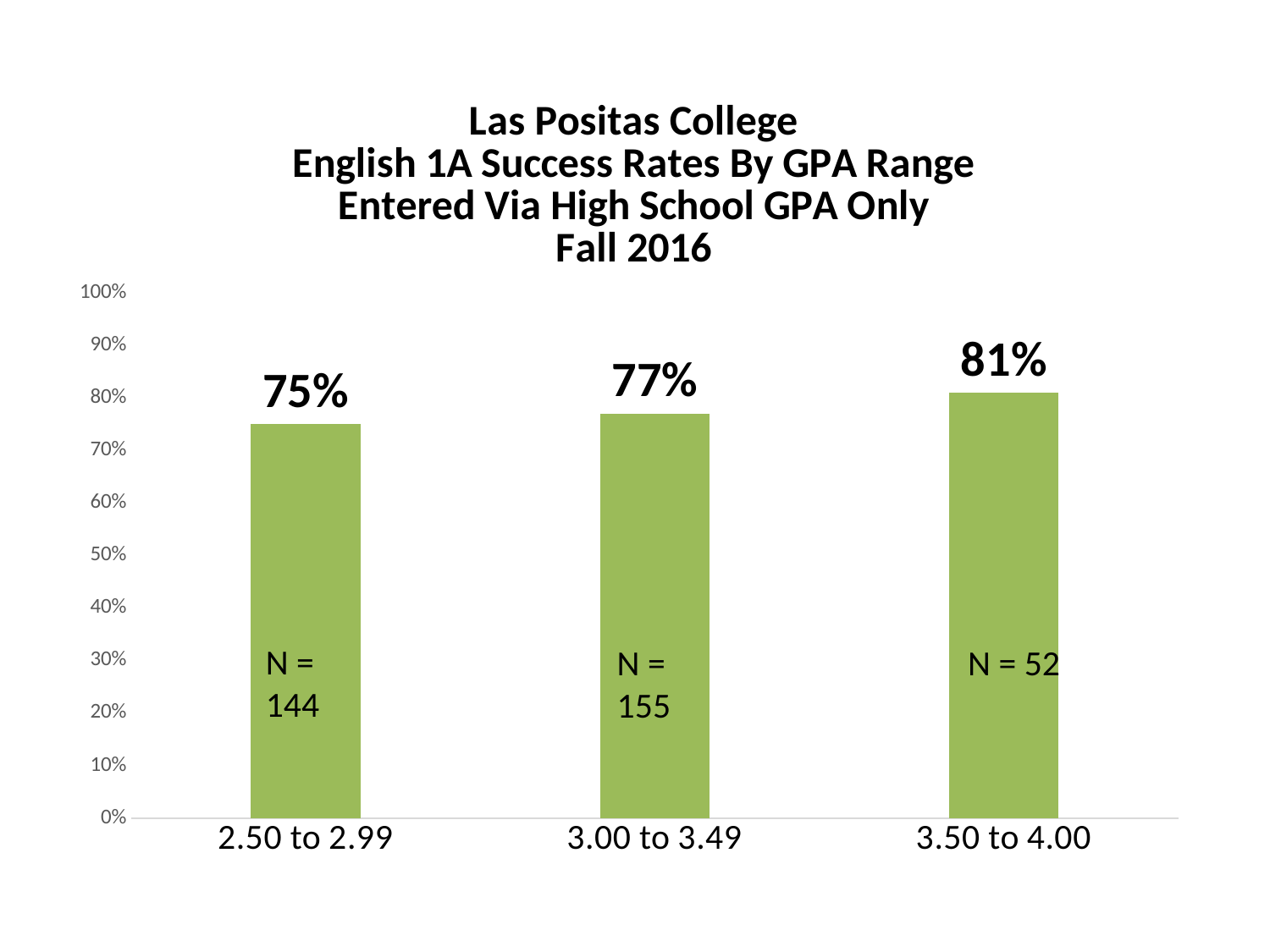
What is the difference in success rate between the 3.50 to 4.00 and 2.50 to 2.99 GPA ranges? 6% Which GPA range has the lowest success rate? 2.50 to 2.99 What is the N (number of students) shown for the 2.50 to 2.99 GPA range? 144 What is the English 1A success rate for the 3.00 to 3.49 GPA range? 77% How many GPA ranges are shown on the chart? 3 Which GPA range has the highest success rate? 3.50 to 4.00 What is the N (number of students) shown for the 3.50 to 4.00 GPA range? 52 What is the English 1A success rate for the 3.50 to 4.00 GPA range? 81% What is the English 1A success rate for the 2.50 to 2.99 GPA range? 75% What kind of chart is shown on the slide? Bar chart Do the success rates rise or fall as the GPA range increases from left to right? Rise Which has a higher success rate, the 3.00 to 3.49 range or the 3.50 to 4.00 range? 3.50 to 4.00